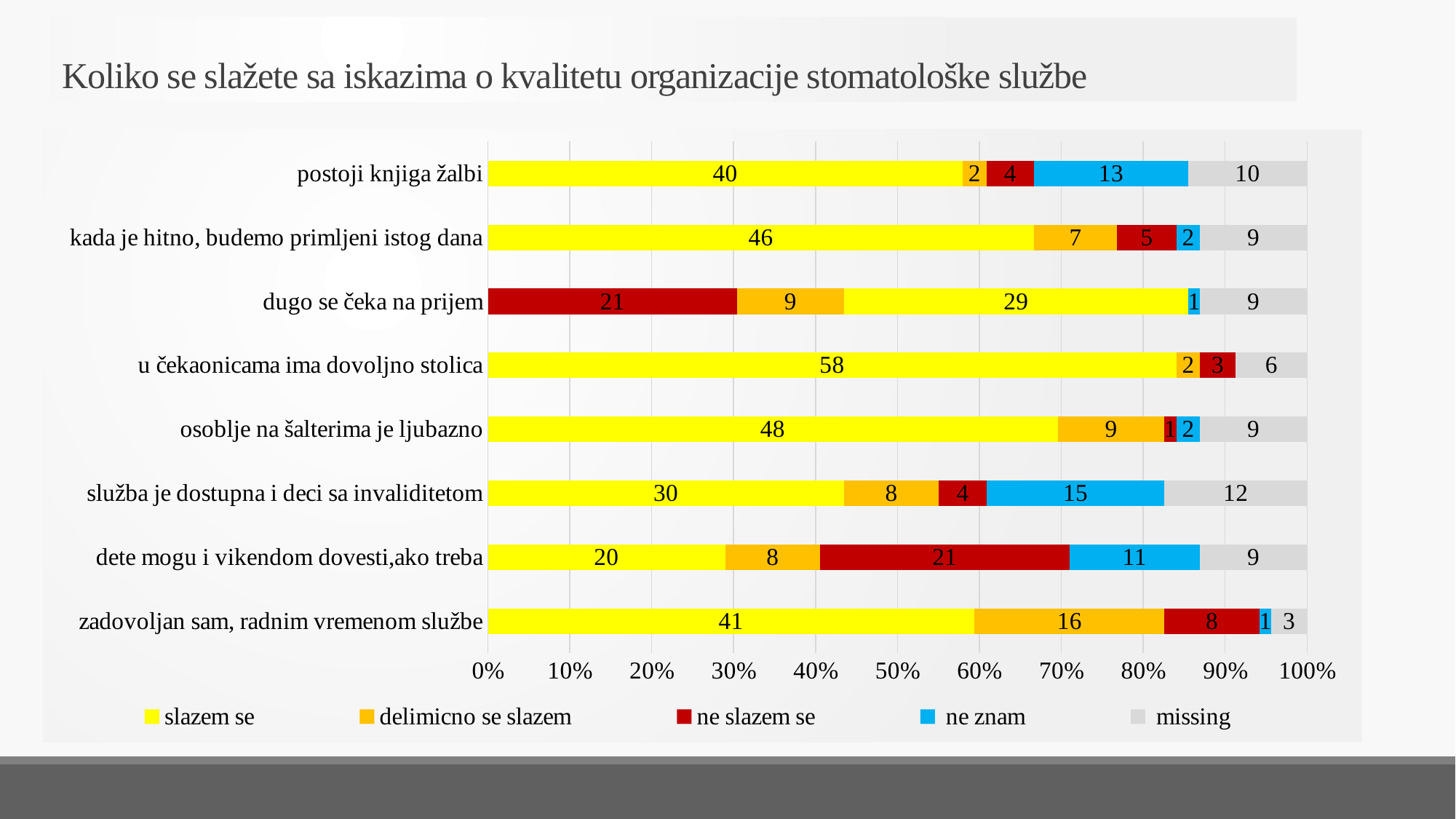
What is the total of the stacked bar for "postoji knjiga žalbi"? 69 Which statement has the lowest "slazem se" value? dete mogu i vikendom dovesti,ako treba How many statements (categories) are plotted on the chart? 8 What is the value of "ne znam" for "služba je dostupna i deci sa invaliditetom"? 15 What type of chart is shown on the slide? stacked bar chart Which is larger: the "missing" value for "služba je dostupna i deci sa invaliditetom" or for "postoji knjiga žalbi"? služba je dostupna i deci sa invaliditetom How many series does the legend list? 5 What is the value of "slazem se" for "u čekaonicama ima dovoljno stolica"? 58 What is the difference between the "slazem se" values for "kada je hitno, budemo primljeni istog dana" and "postoji knjiga žalbi"? 6 What is the value of "delimicno se slazem" for "zadovoljan sam, radnim vremenom službe"? 16 What is the value of "ne slazem se" for "dete mogu i vikendom dovesti,ako treba"? 21 Which statement has the highest "slazem se" value? u čekaonicama ima dovoljno stolica